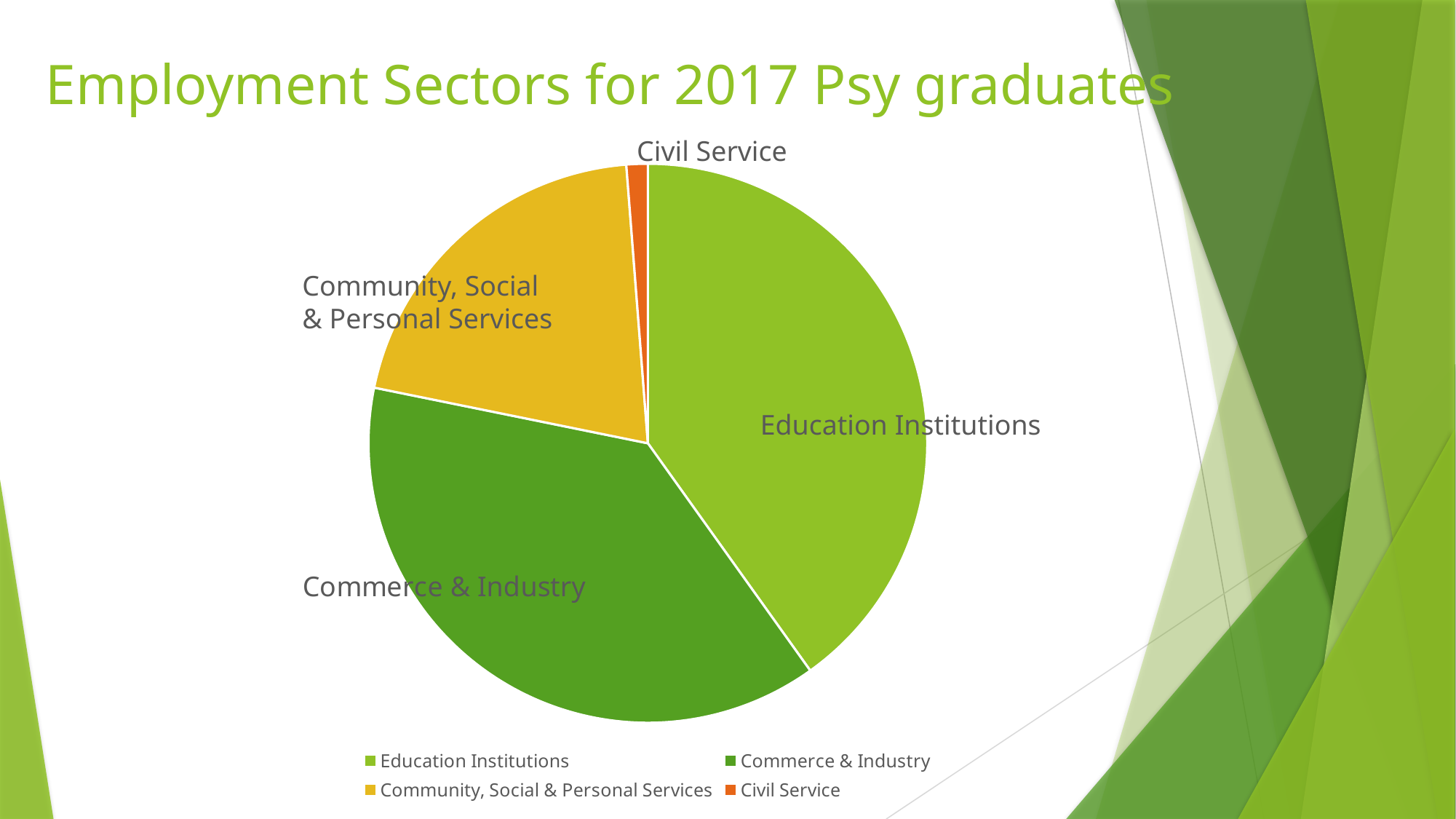
Which slice is larger: Education Institutions or Community, Social & Personal Services? Education Institutions Which slice is larger: Community, Social & Personal Services or Civil Service? Community, Social & Personal Services Which employment sector has the smallest slice of the pie? Civil Service How many slices does the pie chart have? 4 Which slice is larger: Commerce & Industry or Community, Social & Personal Services? Commerce & Industry What colour is the Civil Service slice in the pie chart? Orange How many entries does the legend list? 4 What is the title of the slide containing the pie chart? Employment Sectors for 2017 Psy graduates What kind of chart is shown on the slide? Pie chart